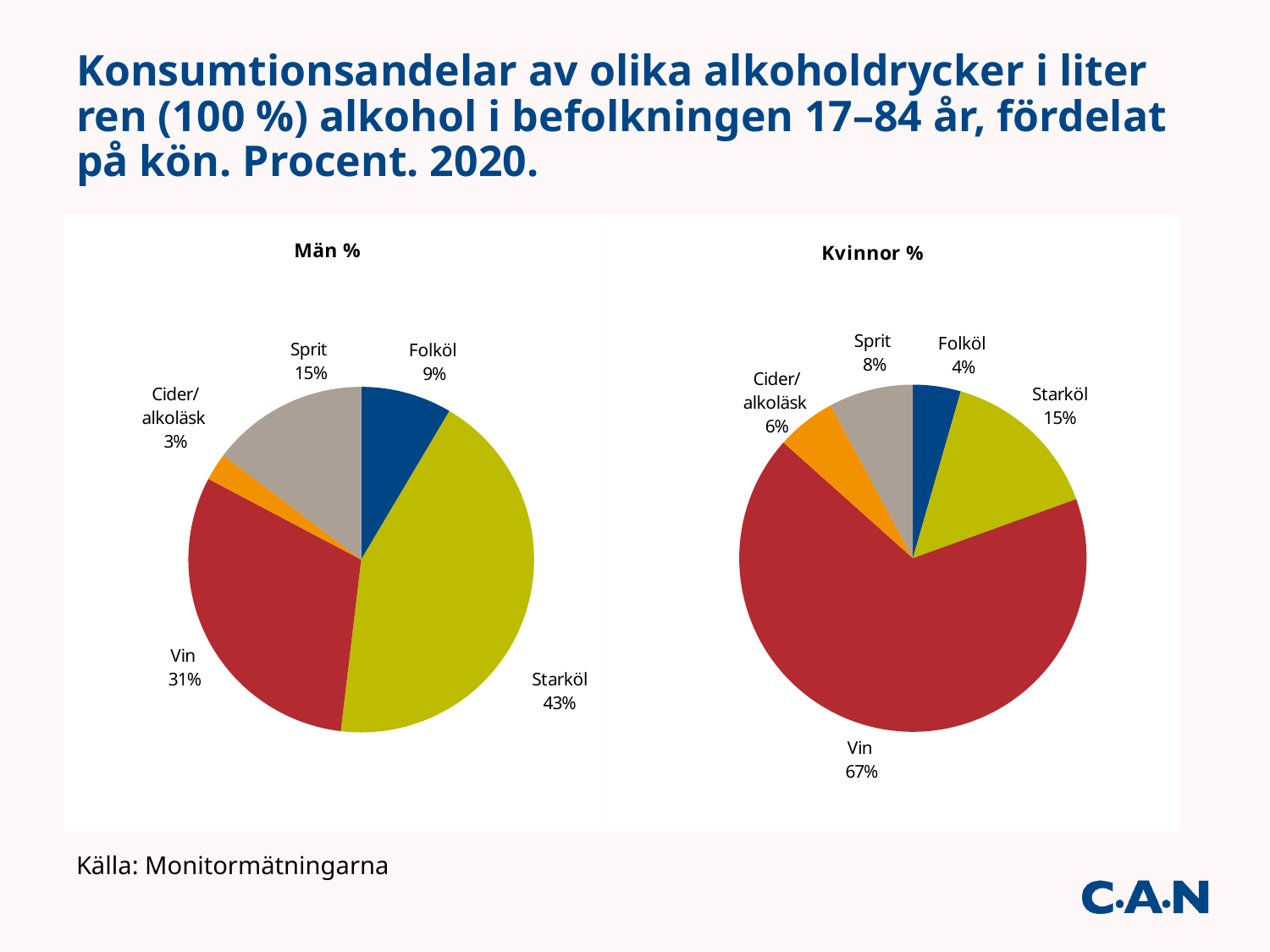
What type of chart is used on this slide? Pie chart What is the title of the chart on the left? Män % In the "Män %" pie chart, what share does Starköl have? 43% In the "Kvinnor %" pie chart, what share does Folköl have? 4% In the "Kvinnor %" pie chart, which category has the smallest share? Folköl In the "Män %" pie chart, what is the difference between the shares of Starköl and Vin? 12 percentage points In the "Män %" pie chart, which category has the largest share? Starköl How many categories are shown in the "Kvinnor %" pie chart? 5 Which is larger: the share of Sprit in the "Män %" chart or the share of Sprit in the "Kvinnor %" chart? Män % In the "Kvinnor %" pie chart, what share does Vin have? 67% In the "Kvinnor %" pie chart, which category has the largest share? Vin In the "Män %" pie chart, what share does Cider/alkoläsk have? 3%